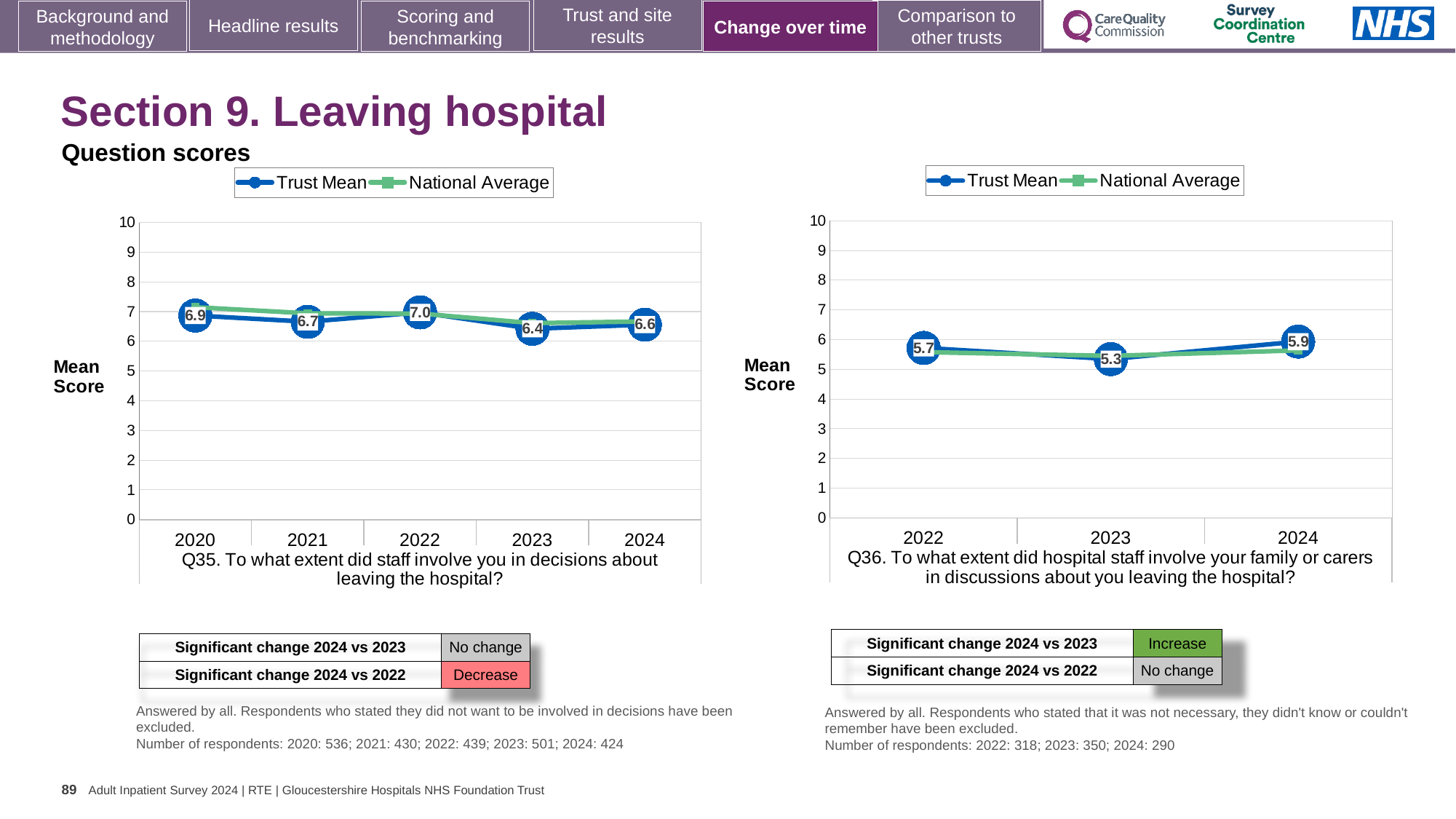
In the Q36 chart (right), is the Trust Mean score for 2022 greater or less than 6? less In the Q35 chart (left), what is the difference between the Trust Mean scores for 2020 and 2024? 0.3 How many years are plotted on the x axis of the Q35 chart (left)? 5 What type of chart is used for the Q35 chart (left)? line chart In the Q35 chart (left), which year has the highest Trust Mean score? 2022 In the Q35 chart (left), is the Trust Mean score for 2021 higher or lower than for 2023? higher How many series does the legend of the Q36 chart (right) list? 2 In the Q36 chart (right), what is the Trust Mean score for 2024? 5.9 In the Q36 chart (right), what is the difference between the Trust Mean scores for 2024 and 2023? 0.6 In the Q36 chart (right), which year has the lowest Trust Mean score? 2023 In the Q35 chart (left), what is the Trust Mean score for 2023? 6.4 In the Q35 chart (left), what is the Trust Mean score for 2022? 7.0